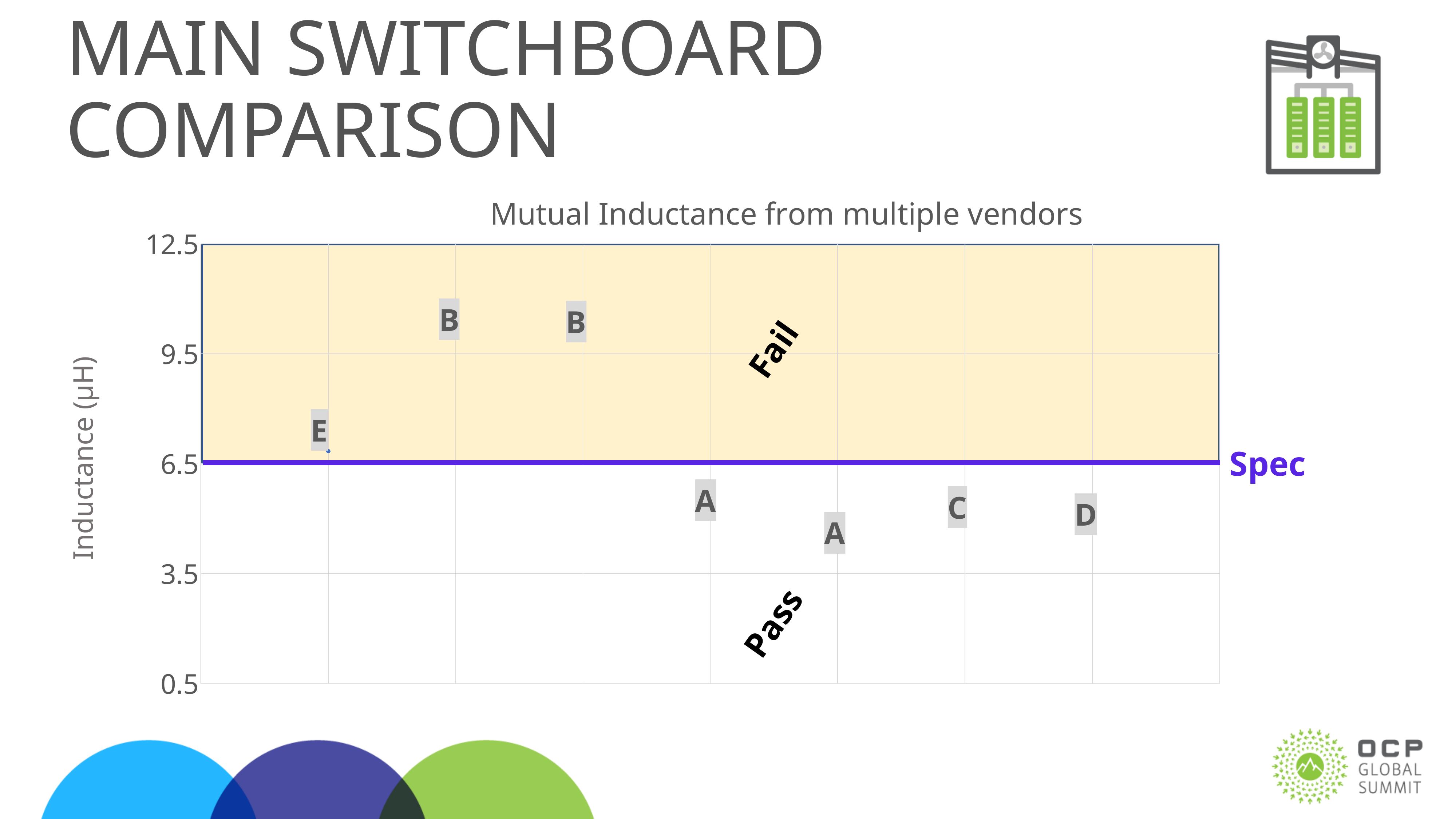
Which vendor has the highest inductance values? B What is the title of the chart? Mutual Inductance from multiple vendors Which vendors have points in the shaded Fail region? B and E Are the values for vendor A greater or less than 6.5? less At what inductance value is the Spec line drawn? 6.5 How many distinct vendors are labeled on the chart? 5 Is the value for vendor E greater or less than 9.5? less What kind of chart is shown on the slide? scatter chart Are the values for vendor B greater or less than 9.5? greater Which vendor has higher inductance, B or A? B How many labeled data points are plotted on the chart? 7